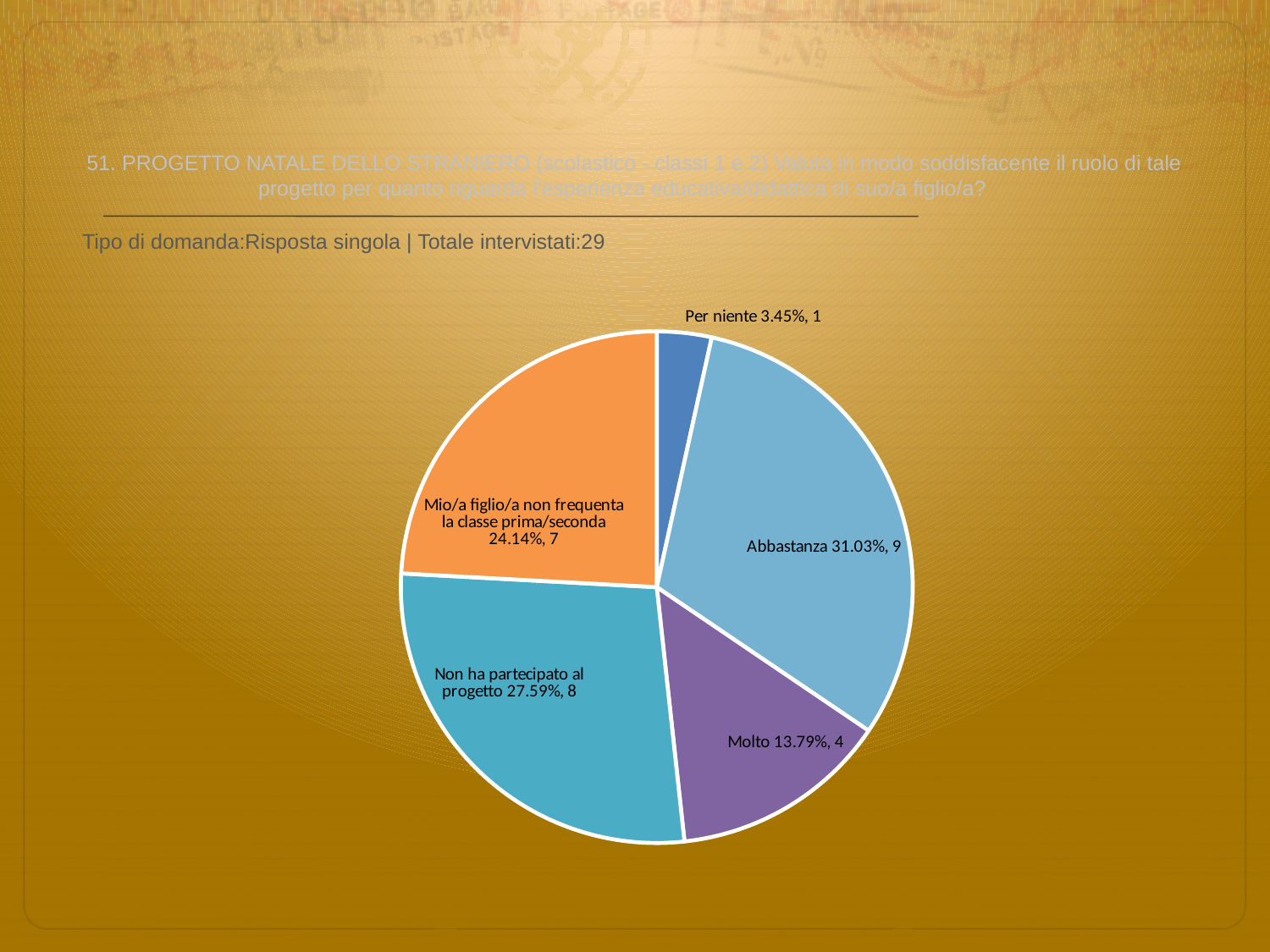
What percentage is shown for the 'Abbastanza' slice? 31.03% What percentage is shown for 'Non ha partecipato al progetto'? 27.59% Which has more respondents, 'Non ha partecipato al progetto' or 'Mio/a figlio/a non frequenta la classe prima/seconda'? Non ha partecipato al progetto How many slices does the pie chart have? 5 Which category has the smallest slice of the pie? Per niente What is the total number of respondents shown on the slide? 29 How many respondents chose 'Molto'? 4 What kind of chart is shown on the slide? pie chart Which category has the largest slice of the pie? Abbastanza How many respondents chose 'Per niente'? 1 What is the difference in respondent count between 'Abbastanza' and 'Molto'? 5 What colour is the 'Mio/a figlio/a non frequenta la classe prima/seconda' slice? orange